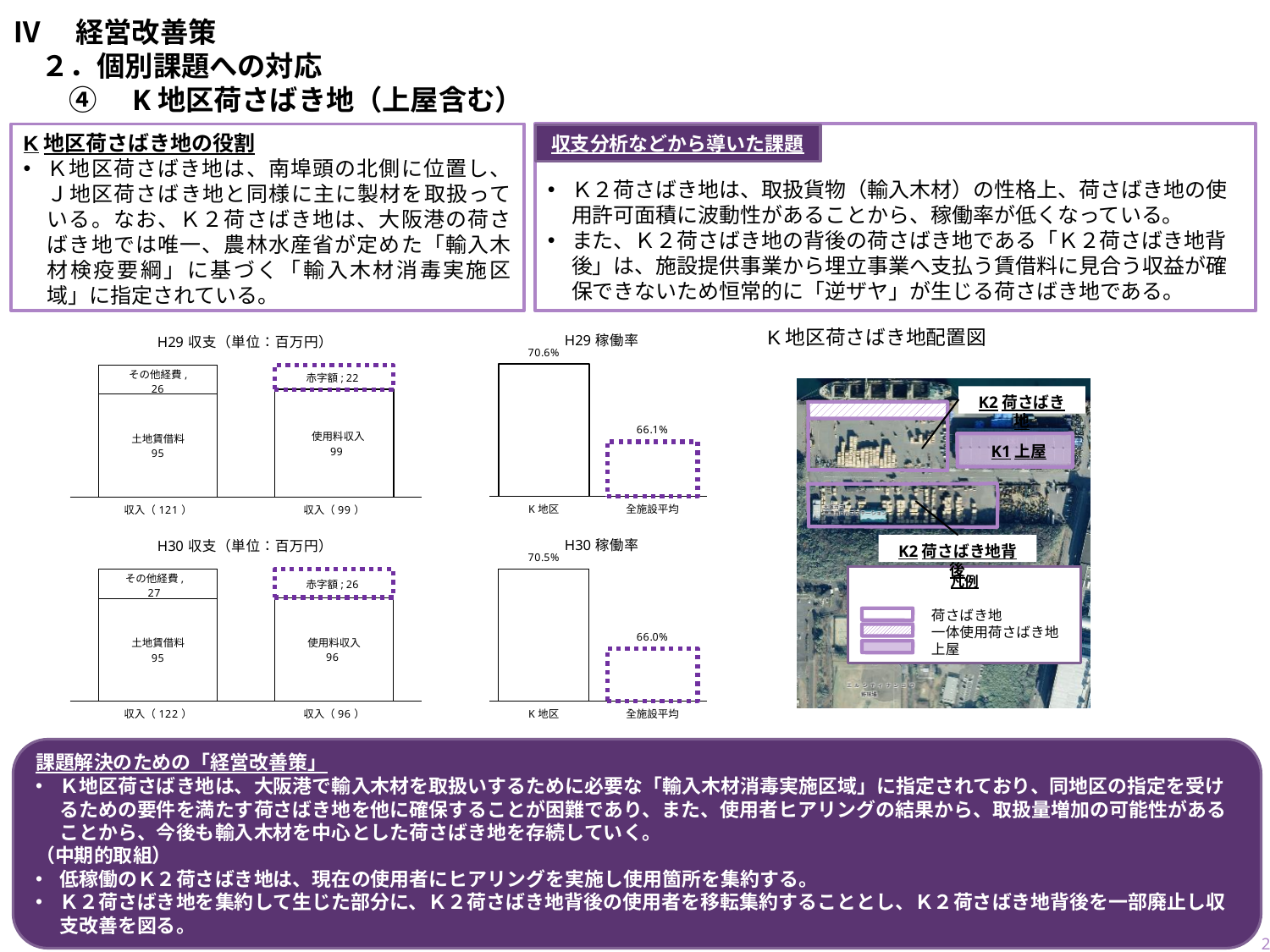
In the H29 収支 chart, what is the value of 土地賃借料? 95 In the H29 稼働率 chart, what is the value for K地区? 70.6% In the H29 収支 chart, what is the 赤字額? 22 What kind of chart is the H30 稼働率 chart? bar chart In the H29 稼働率 chart, what is the value for 全施設平均? 66.1% In the H29 収支 chart, what is the value of 使用料収入? 99 In the H29 収支 chart, what is the total of the left stacked bar (その他経費 plus 土地賃借料)? 121 In the H30 収支 chart, what is the difference between 土地賃借料 and 使用料収入? 1 In the H30 収支 chart, what is the value of その他経費? 27 In the H30 稼働率 chart, what is the difference between K地区 and 全施設平均? 4.5% In the H30 収支 chart, what is the 赤字額? 26 In the H30 稼働率 chart, which is higher, K地区 or 全施設平均? K地区